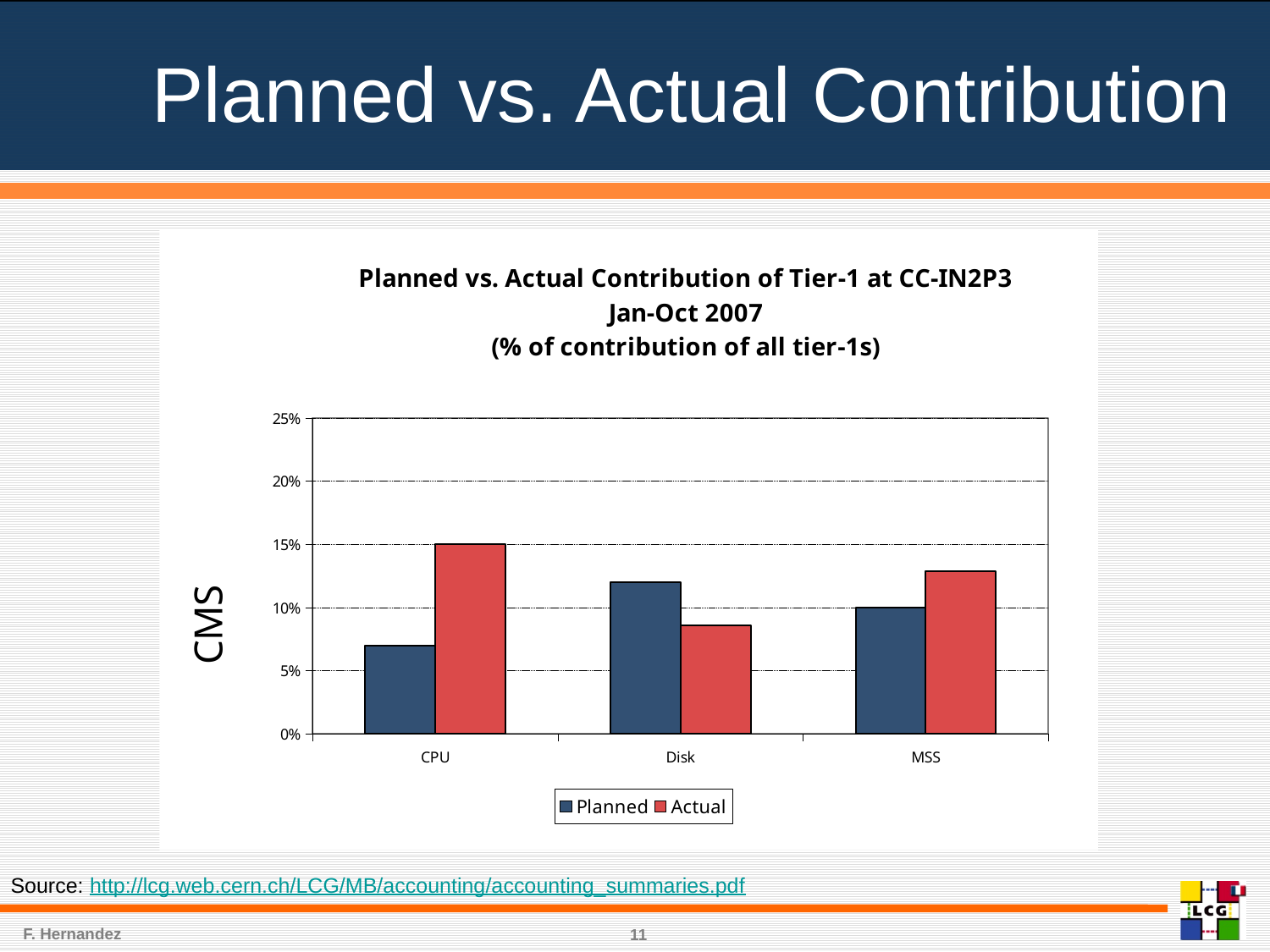
What kind of chart is shown on the slide? bar chart Is the Actual value for MSS greater or less than 10%? greater How many categories are shown on the x axis of the chart? 3 For Disk, which is larger: the Planned or the Actual contribution? Planned Is the Planned value for Disk greater or less than 10%? greater How many series does the chart's legend list? 2 Which category has the highest Actual contribution? CPU Is the Actual value for Disk greater or less than 10%? less For CPU, which is larger: the Planned or the Actual contribution? Actual What are the two series named in the chart's legend? Planned and Actual What label appears on the vertical axis of the chart? CMS